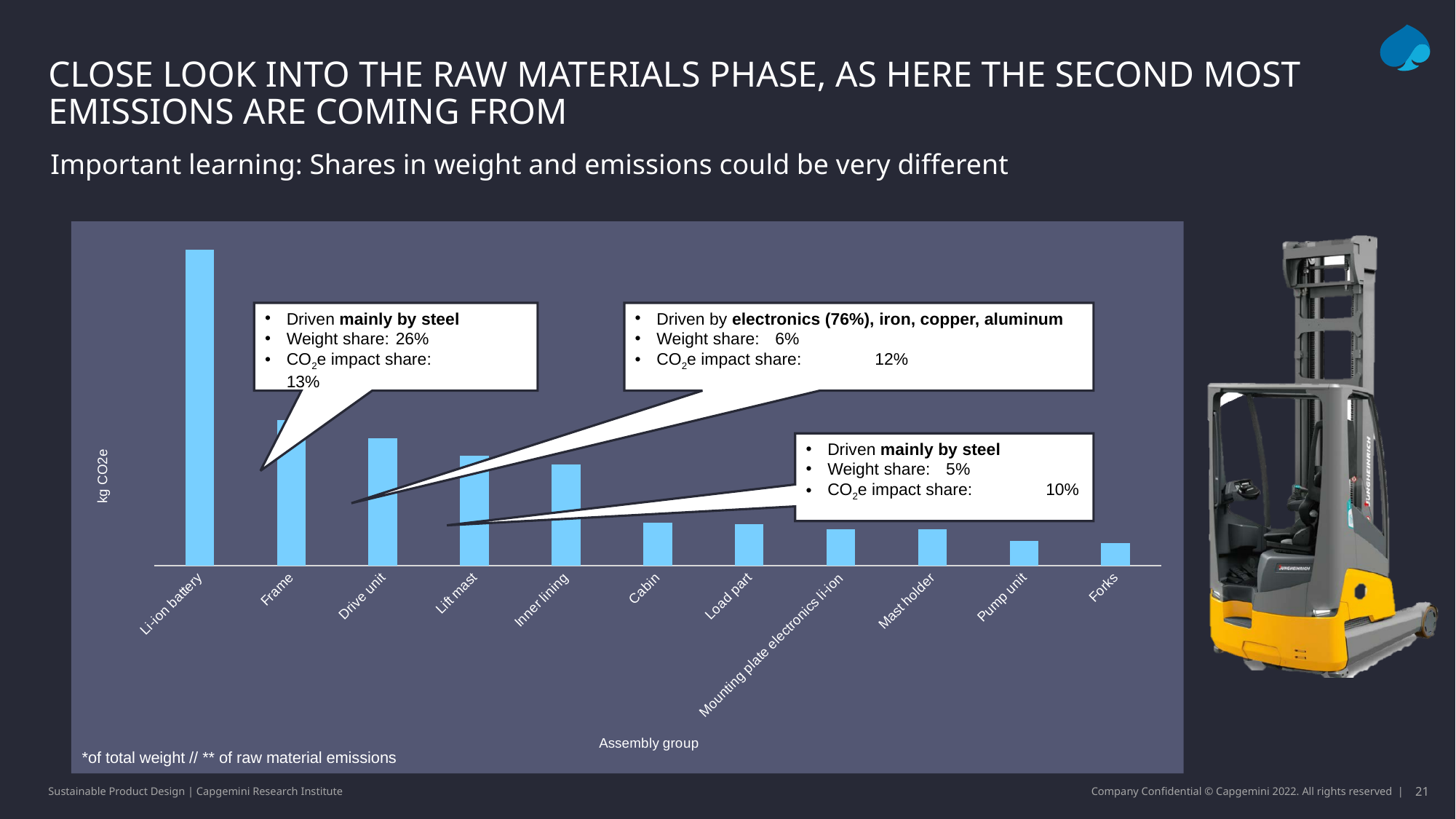
How many assembly groups are plotted on the x axis of the chart? 11 What kind of chart is shown on the slide? Bar chart Do the bar values generally rise or fall from left to right along the x axis? Fall According to the callout for the Frame, what is its CO2e impact share? 13% Which has the larger kg CO2e value, Drive unit or Cabin? Drive unit Which has the larger kg CO2e value, Inner lining or Mast holder? Inner lining What is the label of the y axis of the chart? kg CO2e According to the callout driven by electronics (76%), iron, copper, aluminum, what is the CO2e impact share? 12% What is the label of the x axis of the chart? Assembly group Which has the larger kg CO2e value, Li-ion battery or Frame? Li-ion battery According to the callout for the Frame, what is its weight share? 26% Which assembly group has the highest kg CO2e value in the chart? Li-ion battery